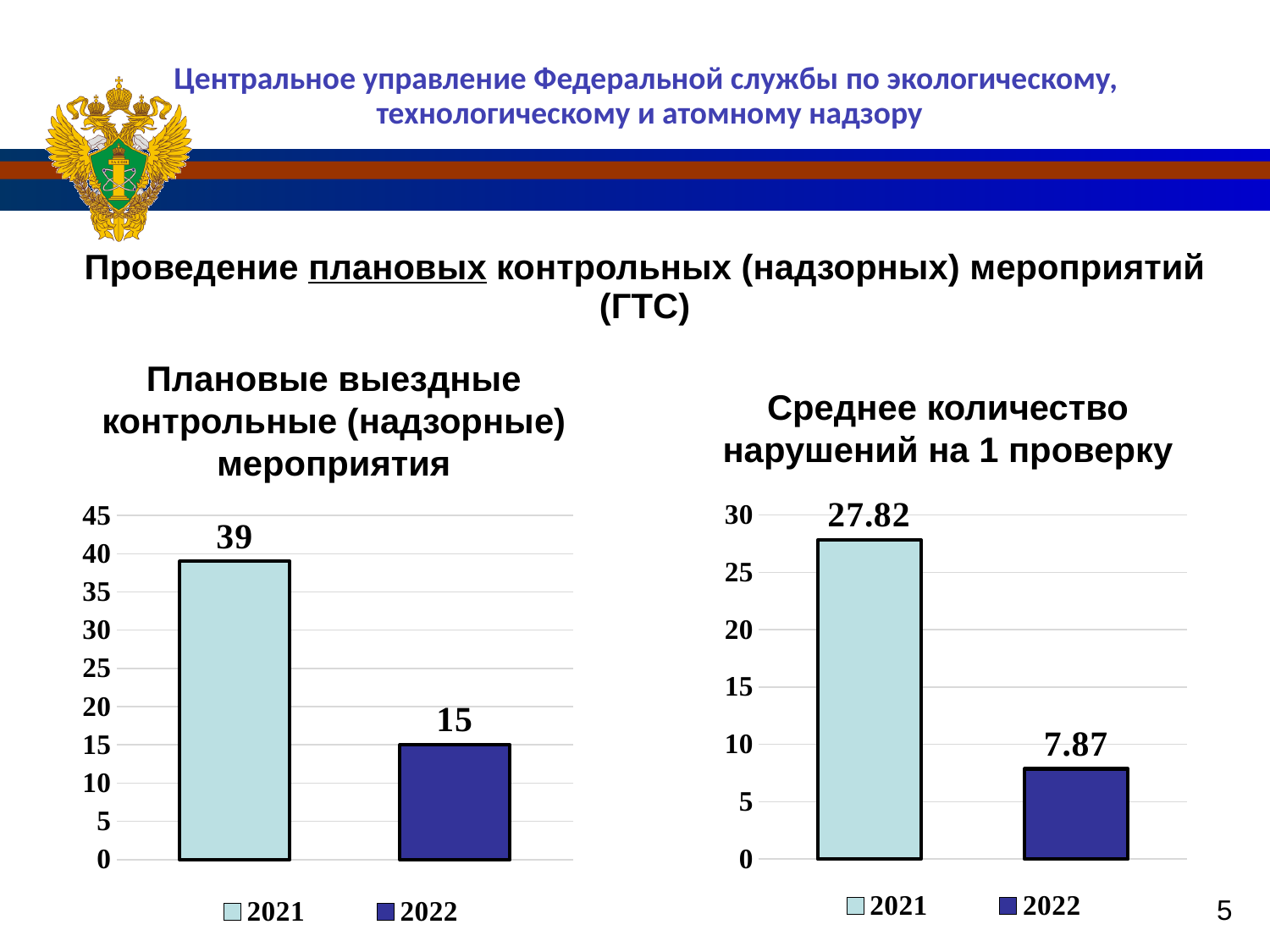
What kind of chart is the chart titled 'Среднее количество нарушений на 1 проверку'? bar chart In the right chart, what is the difference between the 2021 and 2022 values? 19.95 In the left chart, which year has the higher value? 2021 In the chart titled 'Плановые выездные контрольные (надзорные) мероприятия', what is the value for 2022? 15 In the right chart, which year has the lower value? 2022 In the chart titled 'Плановые выездные контрольные (надзорные) мероприятия', what is the value for 2021? 39 In the left chart, what is the difference between the 2021 and 2022 values? 24 In the chart titled 'Среднее количество нарушений на 1 проверку', what is the value for 2022? 7.87 How many series does the legend of the left chart list? 2 In the chart titled 'Среднее количество нарушений на 1 проверку', what is the value for 2021? 27.82 In the left chart, do the values rise or fall from 2021 to 2022? fall In the right chart, is the value for 2022 greater or less than 10? less